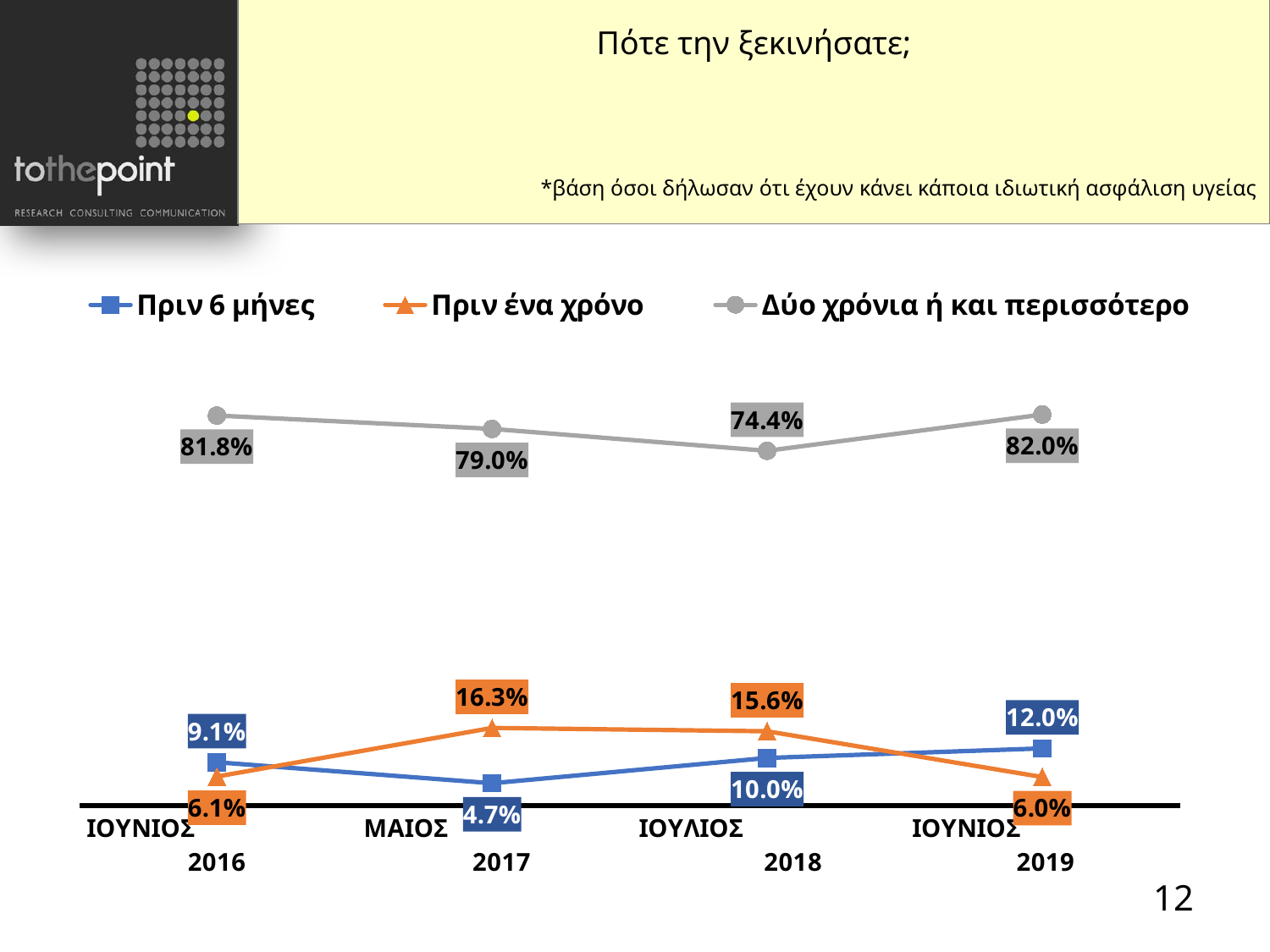
What is the value for 'Πριν ένα χρόνο' in ΜΑΙΟΣ 2017? 16.3% In which time point is the value for 'Δύο χρόνια ή και περισσότερο' lowest? ΙΟΥΛΙΟΣ 2018 How many time points are plotted along the x axis? 4 What is the value for 'Πριν 6 μήνες' in ΙΟΥΛΙΟΣ 2018? 10.0% What is the value for 'Δύο χρόνια ή και περισσότερο' in ΙΟΥΝΙΟΣ 2019? 82.0% Does the value for 'Πριν 6 μήνες' rise or fall from ΜΑΙΟΣ 2017 to ΙΟΥΝΙΟΣ 2019? rise What is the difference between the 'Δύο χρόνια ή και περισσότερο' values in ΙΟΥΝΙΟΣ 2019 and ΙΟΥΛΙΟΣ 2018? 7.6% Which series is drawn with orange triangle markers? Πριν ένα χρόνο How many series does the legend list? 3 Which is larger in ΙΟΥΝΙΟΣ 2016: 'Πριν 6 μήνες' or 'Πριν ένα χρόνο'? Πριν 6 μήνες What type of chart is shown on the slide? line chart In which time point is the value for 'Πριν 6 μήνες' highest? ΙΟΥΝΙΟΣ 2019